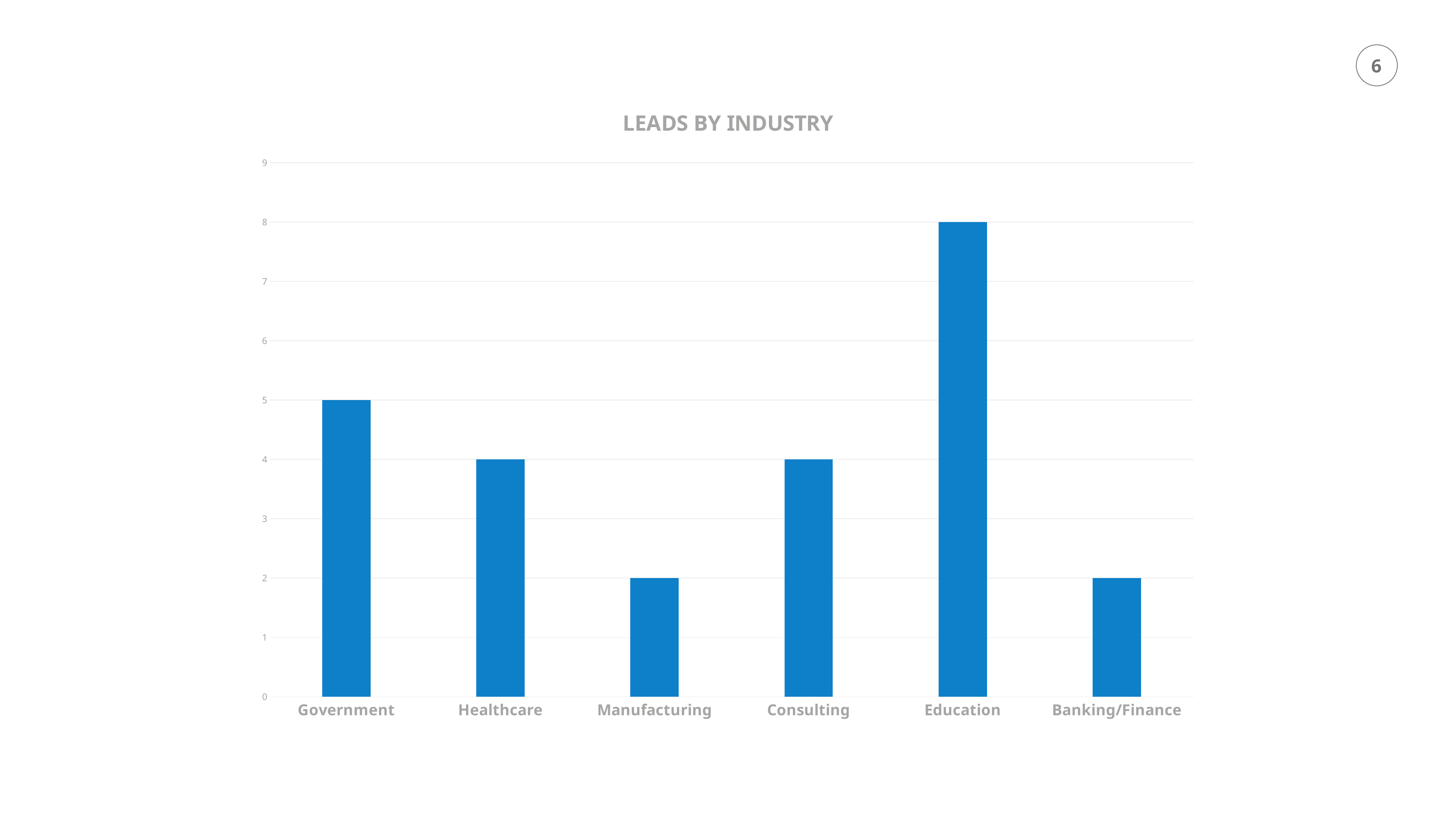
What is the value for Manufacturing? 2 Is the value for Banking/Finance greater or less than 3? less What is the value for Consulting? 4 What is the value for Education? 8 How many industries are shown on the chart? 6 What kind of chart is shown on the slide? Bar chart What is the title of the chart? LEADS BY INDUSTRY What is the value for Government? 5 Which industry has the highest number of leads? Education Is the value for Education greater or less than 6? greater Which is larger, the value for Government or the value for Healthcare? Government What is the difference between the values for Education and Government? 3